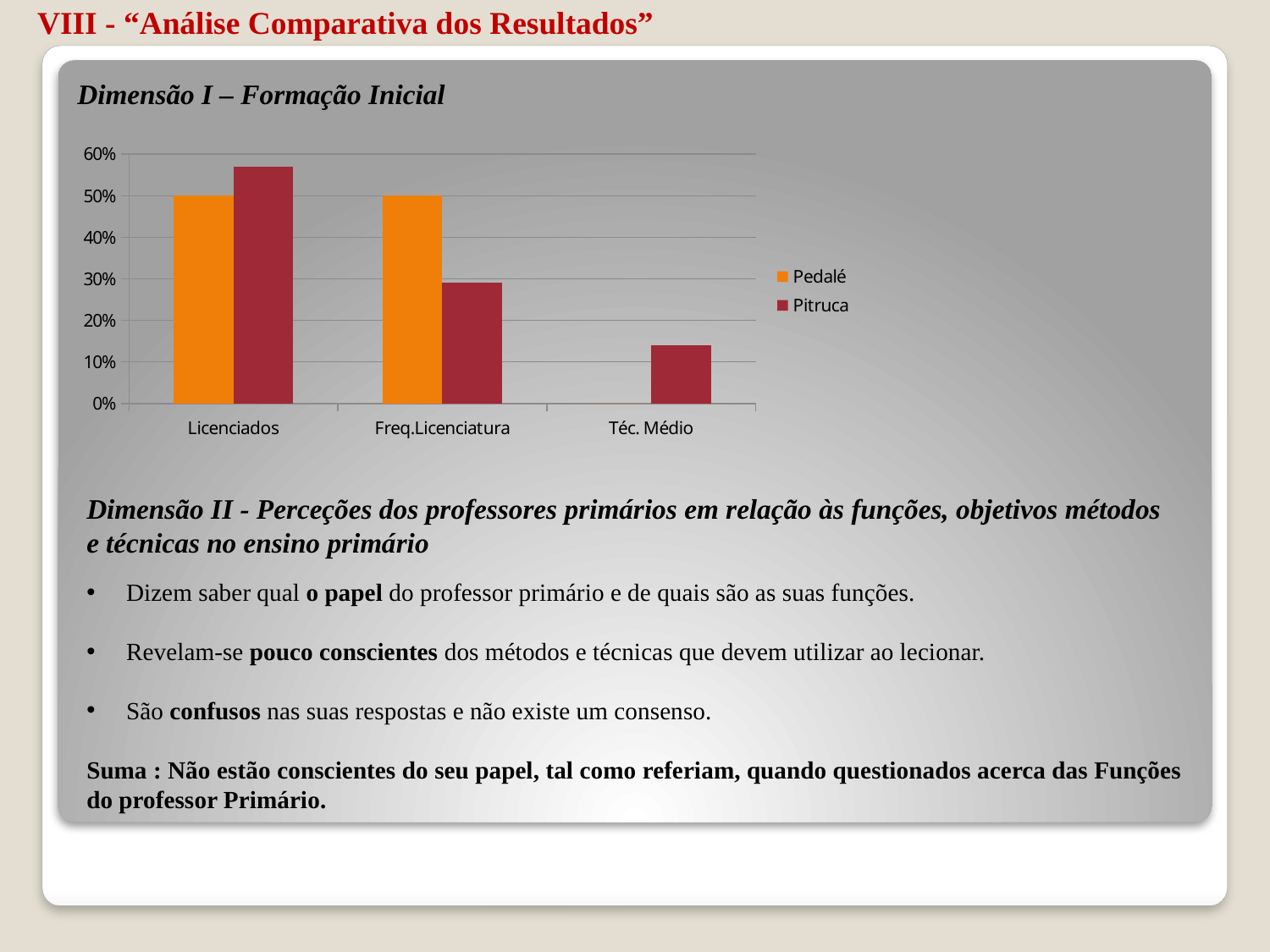
Is the value for Pitruca in the Licenciados category greater or less than 50%? greater What is the value for Pedalé in the Freq.Licenciatura category? 50% In the Licenciados category, which series has the larger value, Pedalé or Pitruca? Pitruca What kind of chart is shown under "Dimensão I – Formação Inicial"? bar chart How many series does the legend of the chart list? 2 For the Pitruca series, which category has the highest value? Licenciados Is the value for Pitruca in the Téc. Médio category greater or less than 20%? less Do the values for the Pitruca series rise or fall from Licenciados to Téc. Médio? fall Is the value for Pitruca in the Freq.Licenciatura category greater or less than 40%? less How many categories are shown on the x axis of the chart? 3 What is the value for Pedalé in the Licenciados category? 50% In the Freq.Licenciatura category, which series has the larger value, Pedalé or Pitruca? Pedalé